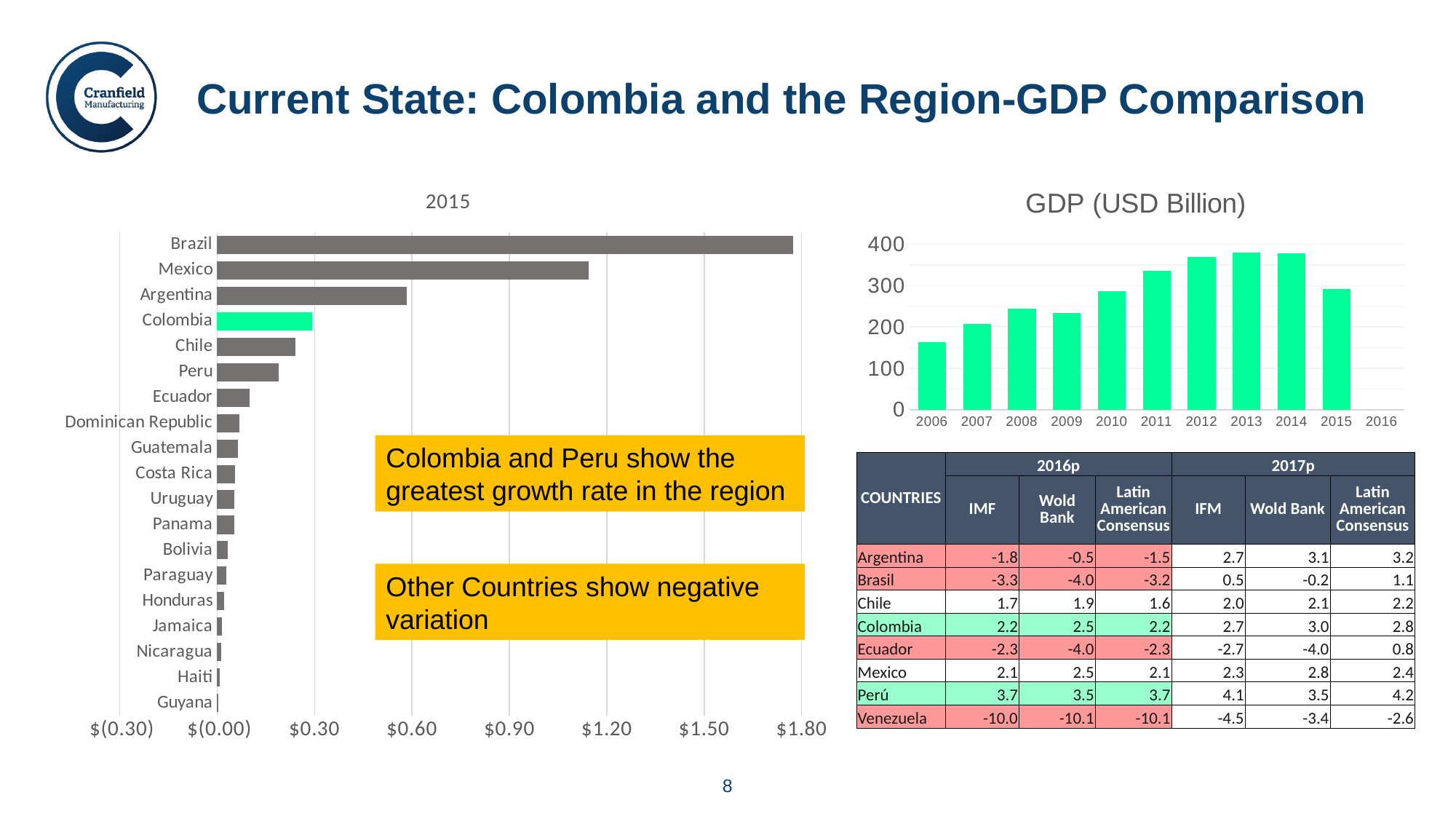
On the chart titled "2015", how many countries are listed on the axis? 19 On the chart titled "2015", which is larger, the value for Colombia or the value for Peru? Colombia On the chart titled "2015", is the value for Chile greater or less than $0.30? less On the chart titled "GDP (USD Billion)", do the values rise or fall from 2006 to 2013? Rise On the chart titled "GDP (USD Billion)", which year has the lowest value? 2006 On the chart titled "2015", which country has the highest value? Brazil On the chart titled "2015", which bar is shown in a different colour from the others? Colombia On the chart titled "2015", is the value for Mexico greater or less than $0.90? greater What kind of chart is the chart titled "2015"? Bar chart On the chart titled "2015", is the value for Argentina greater or less than $0.30? greater